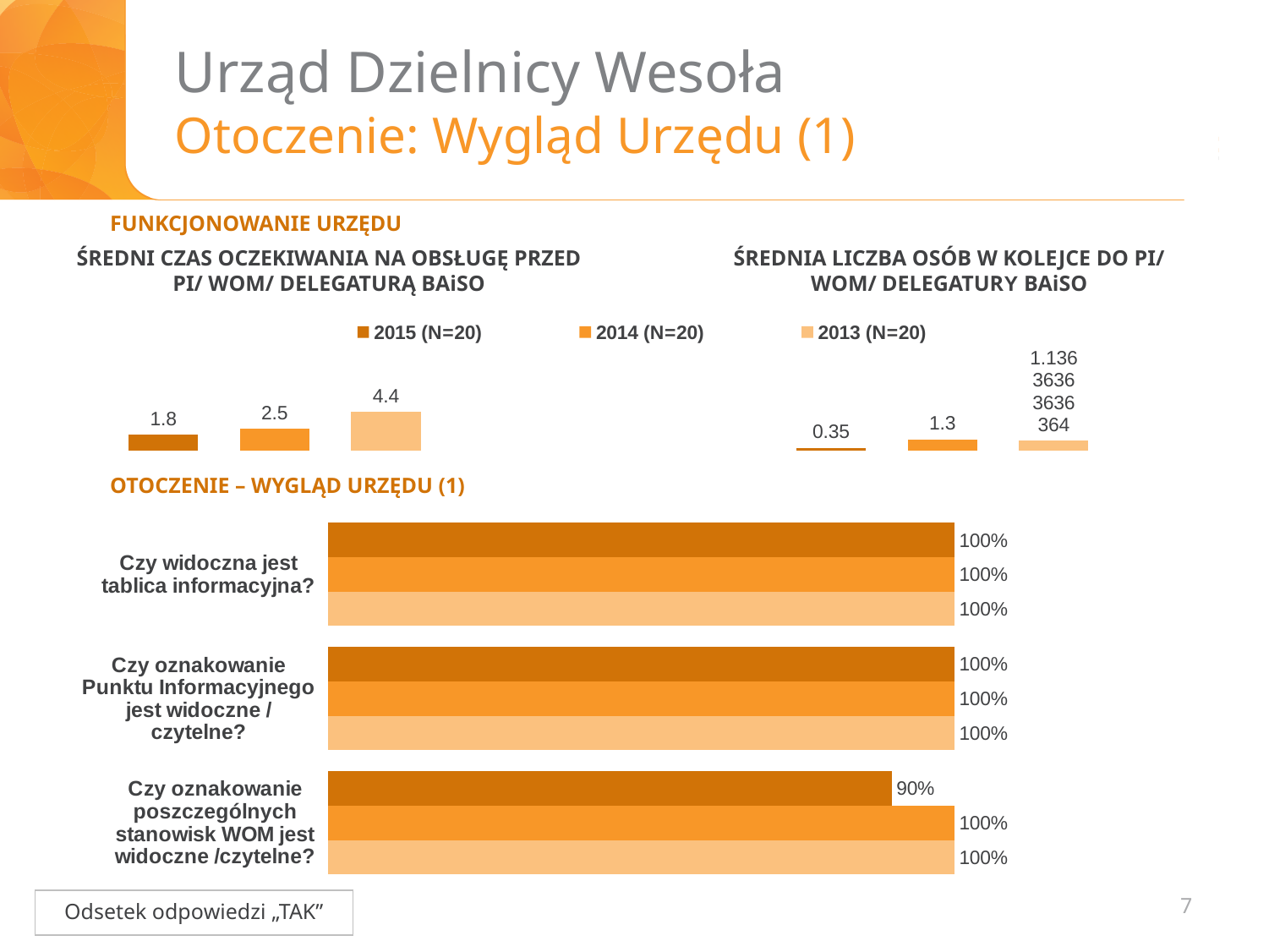
How many series does the legend list for the charts on this slide? 3 What type of chart is 'OTOCZENIE – WYGLĄD URZĘDU (1)'? Bar chart In the chart 'ŚREDNI CZAS OCZEKIWANIA NA OBSŁUGĘ PRZED PI/ WOM/ DELEGATURĄ BAiSO', what is the difference between the 2013 and 2015 values? 2.6 In the chart 'ŚREDNI CZAS OCZEKIWANIA NA OBSŁUGĘ PRZED PI/ WOM/ DELEGATURĄ BAiSO', which year has the highest value? 2013 In the chart 'ŚREDNI CZAS OCZEKIWANIA NA OBSŁUGĘ PRZED PI/ WOM/ DELEGATURĄ BAiSO', what is the value for 2013? 4.4 In the chart 'OTOCZENIE – WYGLĄD URZĘDU (1)', what is the 2015 value for 'Czy oznakowanie poszczególnych stanowisk WOM jest widoczne /czytelne?'? 90% In the chart 'OTOCZENIE – WYGLĄD URZĘDU (1)', what is the 2014 value for 'Czy widoczna jest tablica informacyjna?'? 100% In the chart 'ŚREDNIA LICZBA OSÓB W KOLEJCE DO PI/ WOM/ DELEGATURY BAiSO', what is the value for 2014? 1.3 In the chart 'ŚREDNIA LICZBA OSÓB W KOLEJCE DO PI/ WOM/ DELEGATURY BAiSO', which year has the lowest value? 2015 In the chart 'ŚREDNIA LICZBA OSÓB W KOLEJCE DO PI/ WOM/ DELEGATURY BAiSO', what is the value for 2015? 0.35 In the chart 'OTOCZENIE – WYGLĄD URZĘDU (1)', how many question categories are shown? 3 In the chart 'ŚREDNI CZAS OCZEKIWANIA NA OBSŁUGĘ PRZED PI/ WOM/ DELEGATURĄ BAiSO', what is the value for 2015? 1.8